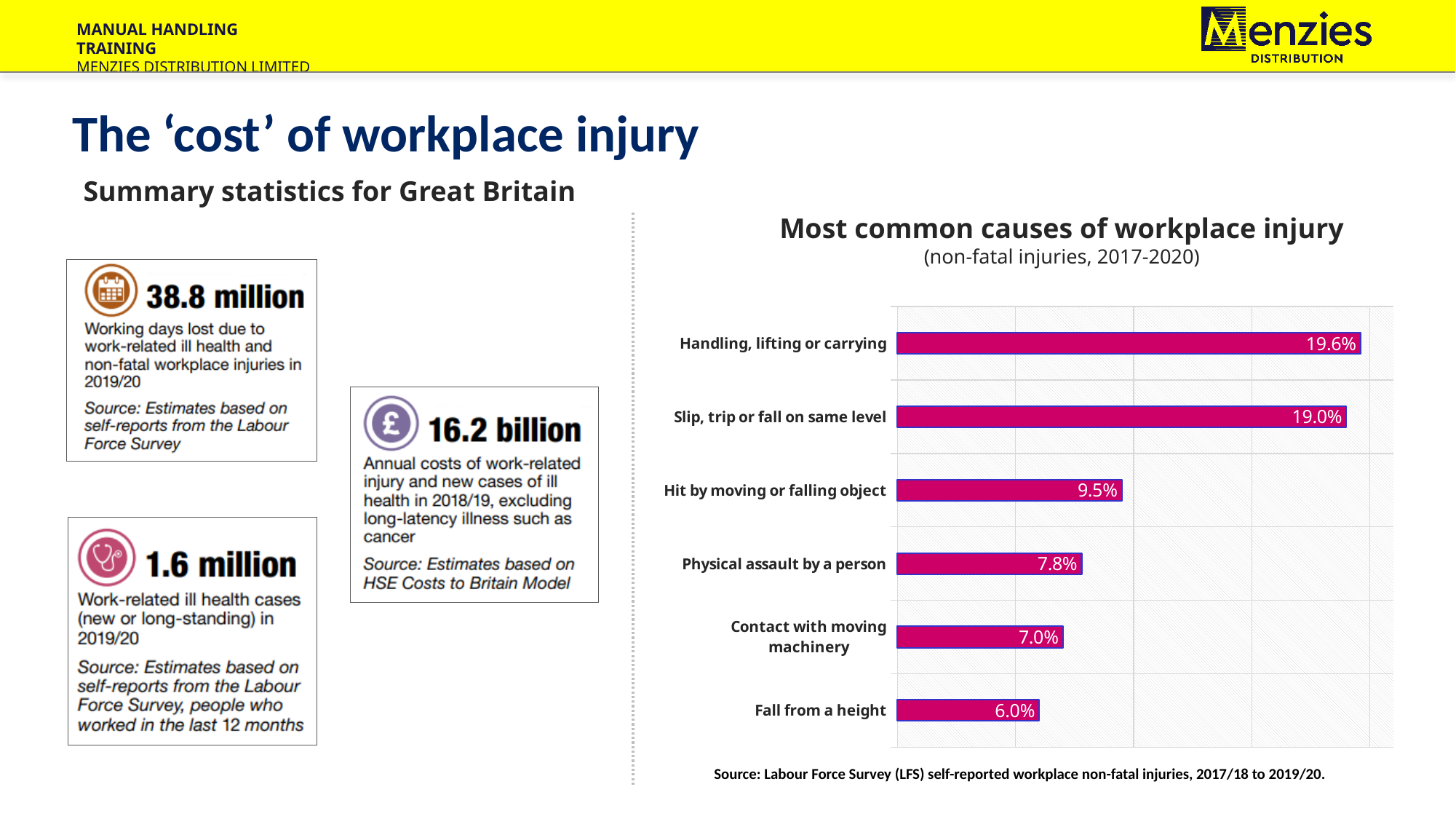
Which is larger, the value for Physical assault by a person or the value for Contact with moving machinery? Physical assault by a person Which cause of workplace injury has the highest value? Handling, lifting or carrying What period does the chart subtitle say the non-fatal injury data covers? 2017-2020 What is the difference between the values for Hit by moving or falling object and Fall from a height? 3.5% How many causes of workplace injury are shown in the chart? 6 What kind of chart is used to show the most common causes of workplace injury? Bar chart What is the difference between the values for Handling, lifting or carrying and Slip, trip or fall on same level? 0.6% What is the value for Handling, lifting or carrying? 19.6% What is the value for Contact with moving machinery? 7.0% What is the title of the chart? Most common causes of workplace injury What is the value for Hit by moving or falling object? 9.5% Which cause of workplace injury has the lowest value? Fall from a height